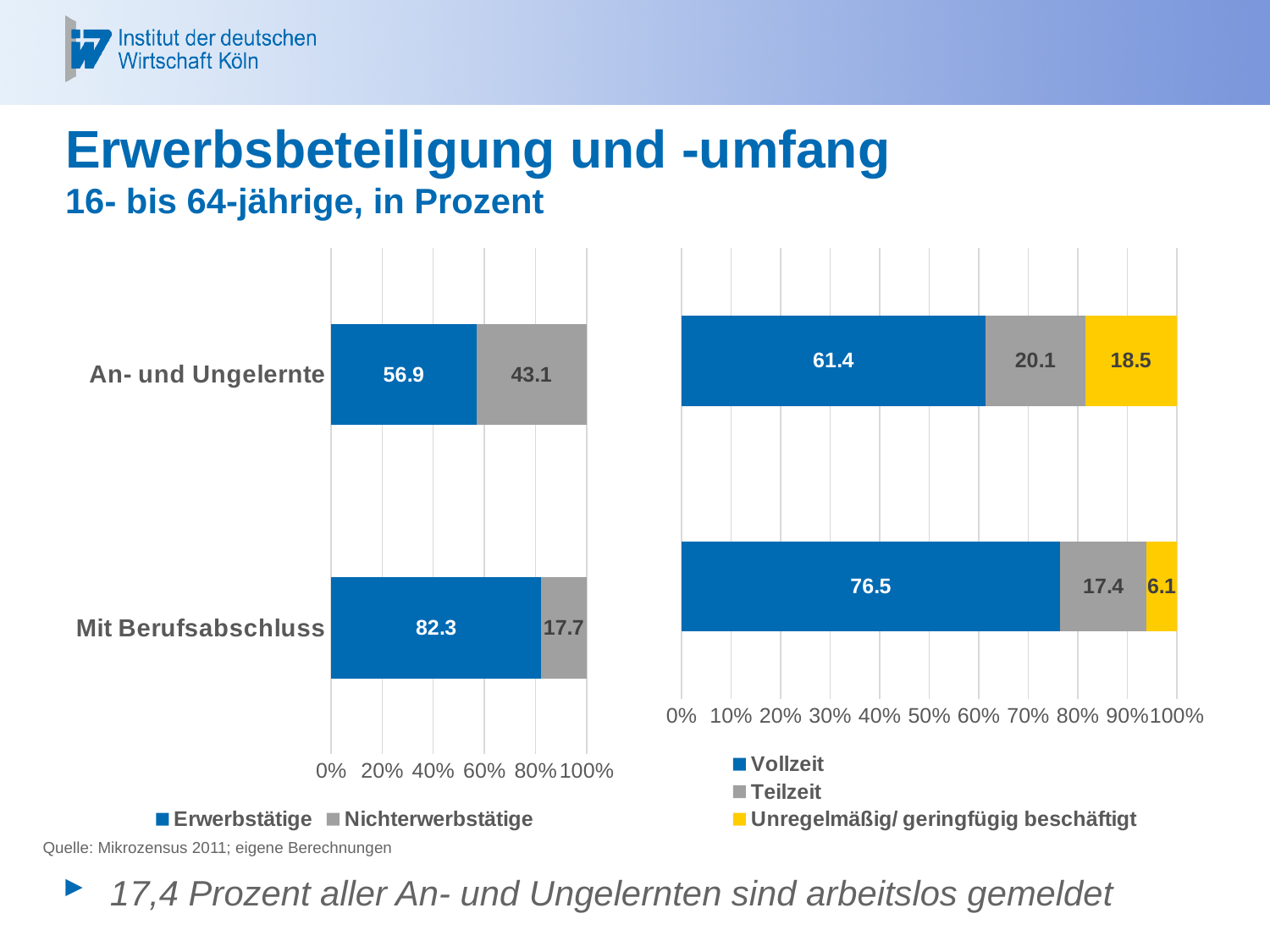
In the left chart, which category has the higher Erwerbstätige value? Mit Berufsabschluss In the right chart, what is the Teilzeit value for An- und Ungelernte? 20.1 In the right chart, what is the Vollzeit value for Mit Berufsabschluss? 76.5 In the right chart, what is the Unregelmäßig/ geringfügig beschäftigt value for An- und Ungelernte? 18.5 In the right chart, which category has the lower Unregelmäßig/ geringfügig beschäftigt value? Mit Berufsabschluss How many series does the legend of the right chart list? 3 What kind of chart is the left chart? Stacked bar chart In the right chart, is the Teilzeit value larger for An- und Ungelernte or for Mit Berufsabschluss? An- und Ungelernte In the left chart, what is the Erwerbstätige value for An- und Ungelernte? 56.9 In the left chart, what is the difference between the Erwerbstätige values for Mit Berufsabschluss and An- und Ungelernte? 25.4 In the right chart, what is the difference between the Vollzeit values for Mit Berufsabschluss and An- und Ungelernte? 15.1 In the left chart, what is the Nichterwerbstätige value for Mit Berufsabschluss? 17.7